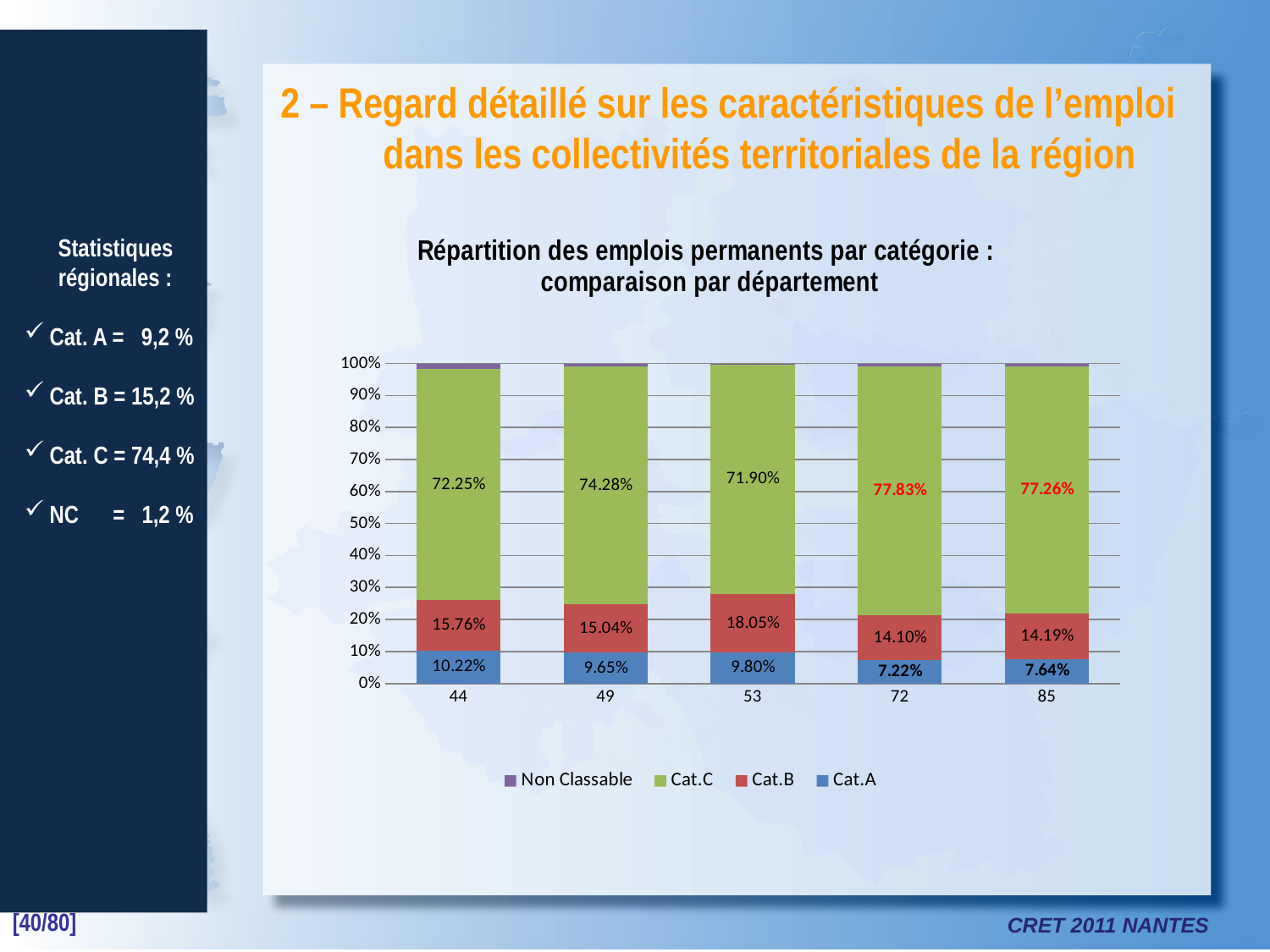
What is the Cat.B value for department 53? 18.05% How many series does the legend list? 4 What is the difference between the Cat.C values for departments 72 and 44? 5.58% How many departments are shown on the x axis? 5 What is the Cat.A value for department 85? 7.64% Which department has the lowest Cat.A value? 72 What kind of chart is shown on the slide? Stacked bar chart What is the Cat.A value for department 44? 10.22% Which department has the highest Cat.C value? 72 Which is larger, the Cat.B value for department 44 or for department 49? 44 Which department has the highest Cat.B value? 53 What is the Cat.C value for department 72? 77.83%